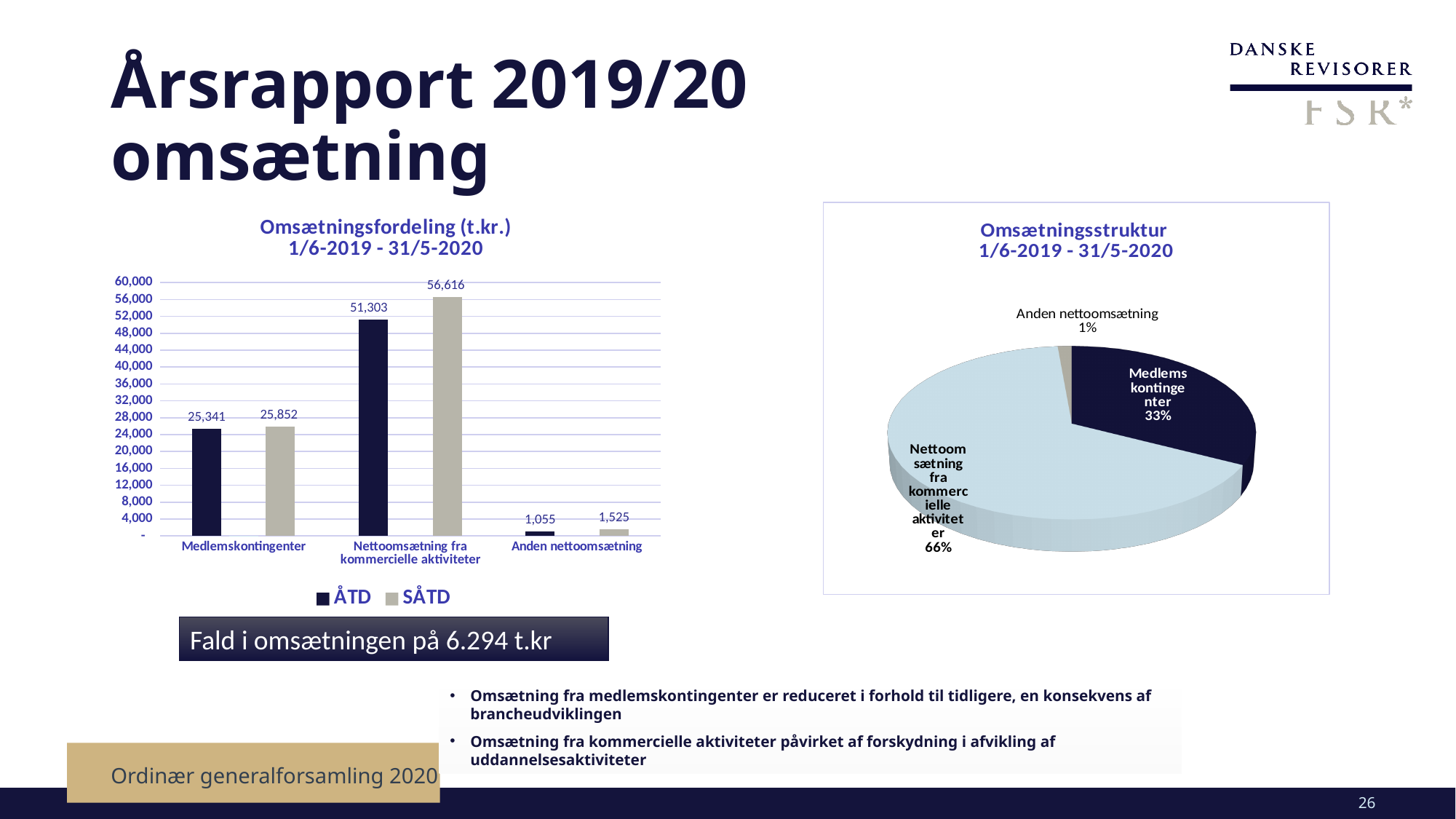
In the Omsætningsfordeling bar chart, what is the ÅTD value for Nettoomsætning fra kommercielle aktiviteter? 51,303 In the Omsætningsfordeling bar chart, which category has the lowest ÅTD value? Anden nettoomsætning What type of chart is the Omsætningsstruktur chart on the right? Pie chart In the Omsætningsstruktur pie chart, what share does Medlemskontingenter have? 33% In the Omsætningsfordeling bar chart, what is the difference between the SÅTD and ÅTD values for Nettoomsætning fra kommercielle aktiviteter? 5,313 How many categories are shown on the x axis of the Omsætningsfordeling bar chart? 3 In the Omsætningsfordeling bar chart, what is the ÅTD value for Anden nettoomsætning? 1,055 In the Omsætningsfordeling bar chart, is the ÅTD or the SÅTD value larger for Anden nettoomsætning? SÅTD In the Omsætningsstruktur pie chart, which slice is the largest? Nettoomsætning fra kommercielle aktiviteter In the Omsætningsfordeling bar chart, what is the SÅTD value for Medlemskontingenter? 25,852 In the Omsætningsfordeling bar chart, which category has the highest SÅTD value? Nettoomsætning fra kommercielle aktiviteter How many series does the legend of the Omsætningsfordeling bar chart list? 2